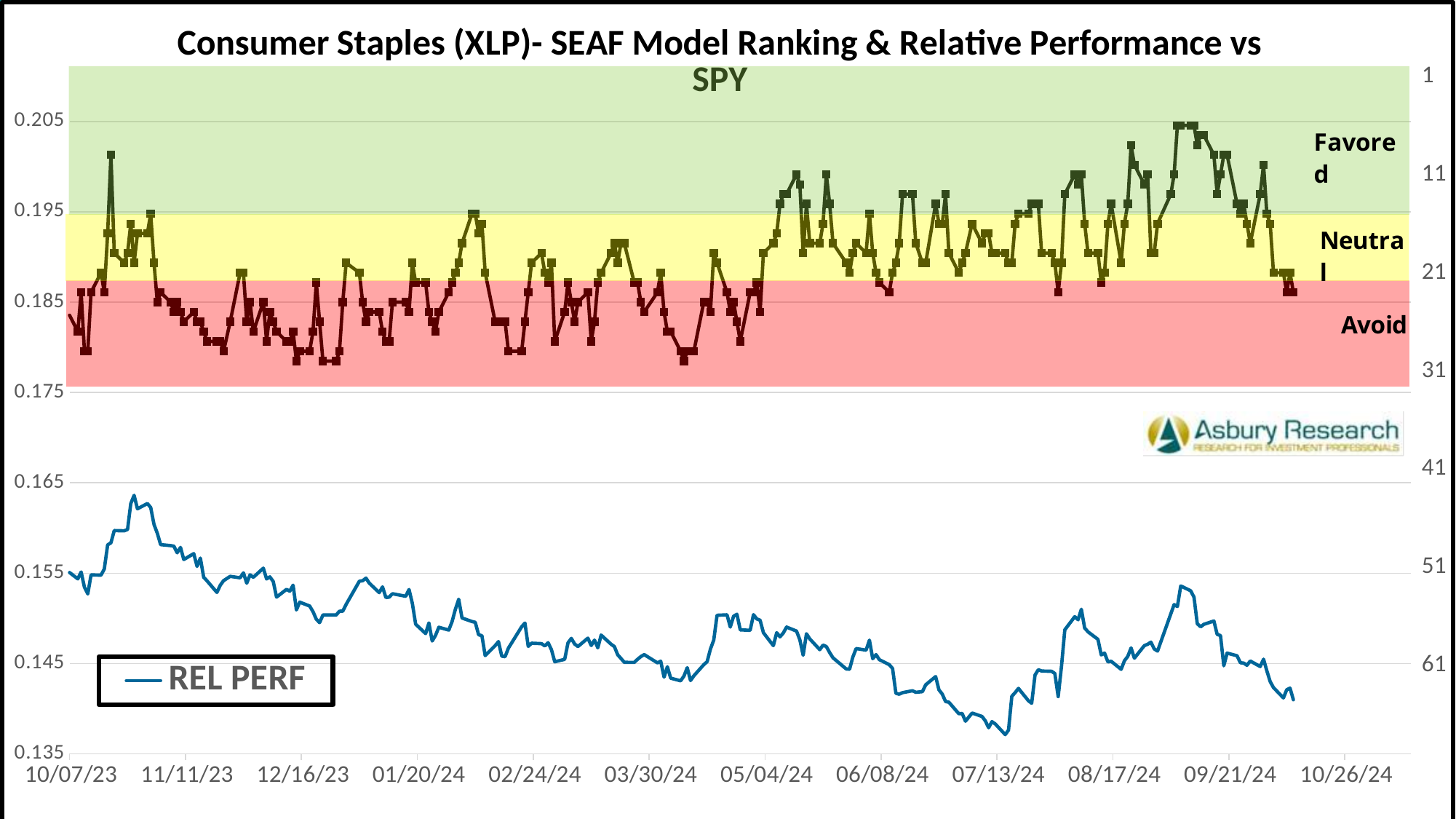
What are the three zone labels shown on the right side of the shaded bands? Favored, Neutral, Avoid Is the REL PERF value at 07/13/24 greater or less than 0.145? less Is the REL PERF value at 05/04/24 greater or less than 0.145? greater What is the lowest value shown on the left vertical axis? 0.135 Is the SEAF model ranking (right axis) at 12/16/23 greater or less than 21? greater What is the name of the series shown in the legend? REL PERF How many date labels are shown on the x axis? 12 What kind of chart is shown on the slide? line chart Does the REL PERF line overall rise or fall from 10/07/23 to the end of the chart? fall How many series does the legend list? 1